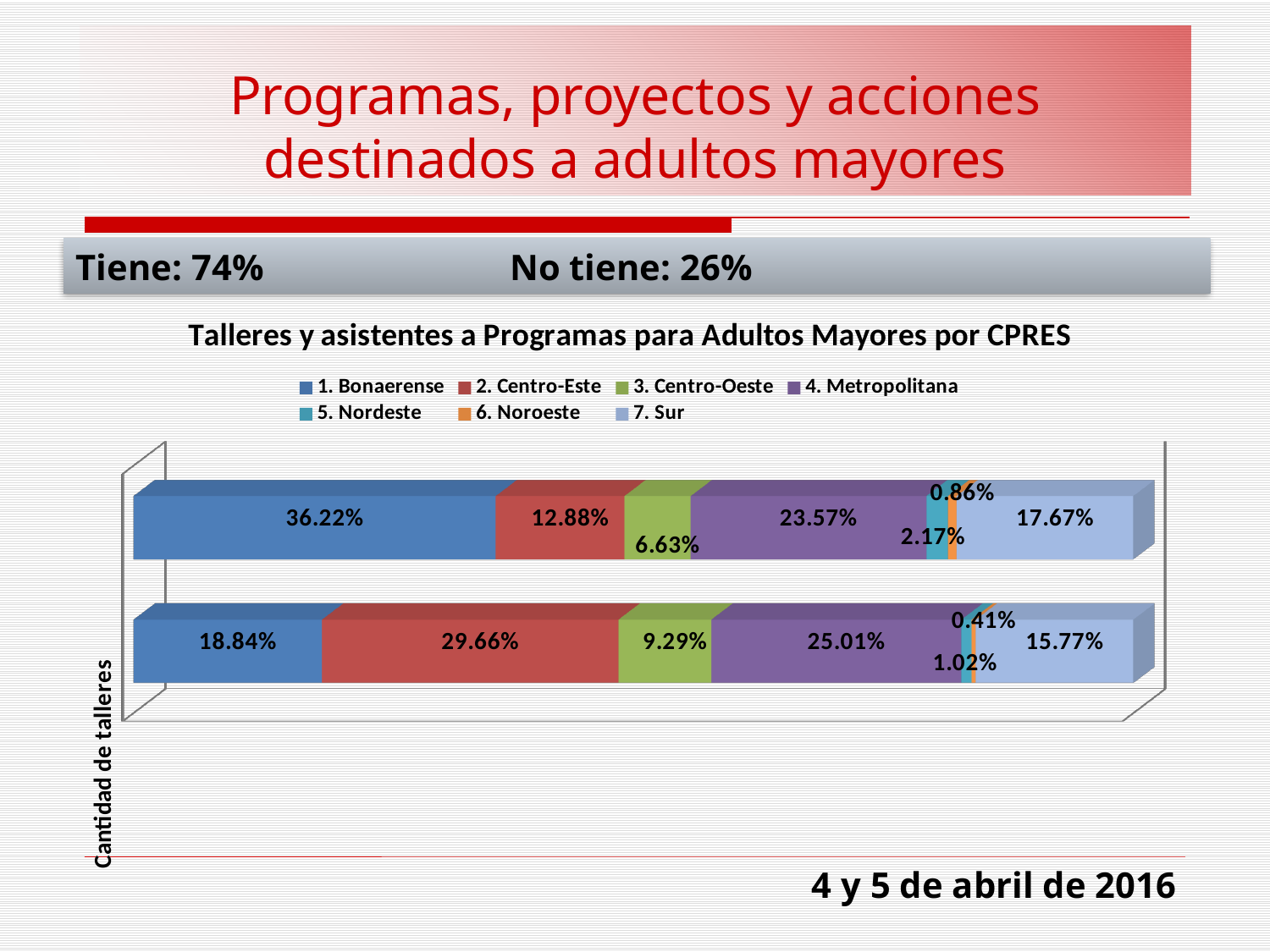
In the top bar, which series has the smallest value? 6. Noroeste What kind of chart is shown on the slide? Stacked bar chart In the top bar, what is the value for 4. Metropolitana? 23.57% What is the difference between the 1. Bonaerense values in the top bar and the bottom bar? 17.38% How many series does the legend list? 7 In the top bar, what is the value for 5. Nordeste? 2.17% In the bottom bar, which series has the largest value? 2. Centro-Este What is the title of the chart? Talleres y asistentes a Programas para Adultos Mayores por CPRES How many bars are plotted in the chart? 2 In the bottom bar, which is larger: 3. Centro-Oeste or 7. Sur? 7. Sur In the bottom bar, what is the value for 2. Centro-Este? 29.66% In the top bar, what is the value for 1. Bonaerense? 36.22%